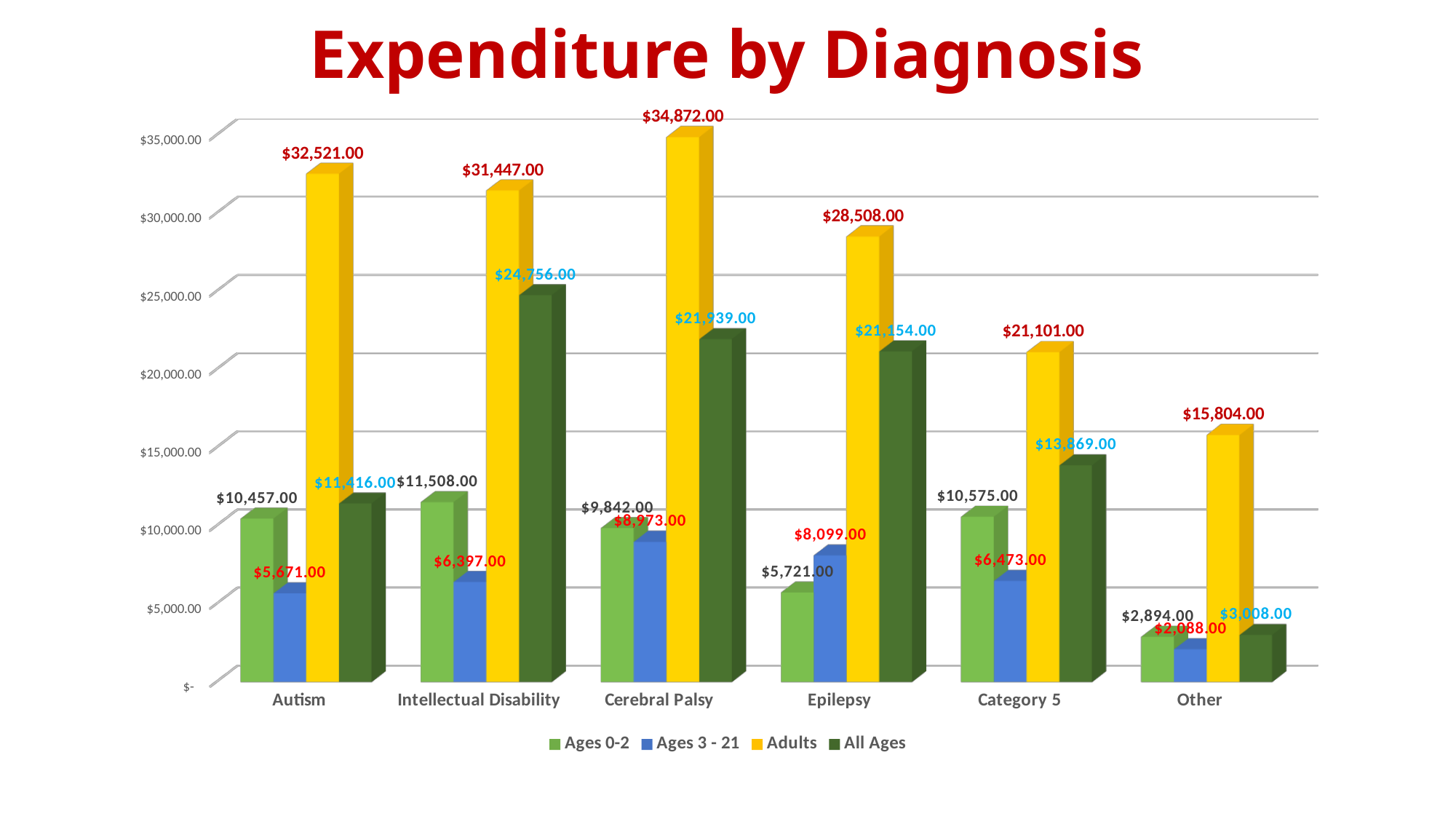
What is the difference between the Adults and Ages 0-2 expenditure for Autism? $22,064.00 Which diagnosis has the highest Adults expenditure? Cerebral Palsy Which is larger, the Ages 0-2 expenditure for Intellectual Disability or for Category 5? Intellectual Disability What is the All Ages expenditure for Intellectual Disability? $24,756.00 Which diagnosis has the lowest All Ages expenditure? Other How many series does the legend list? 4 What is the Adults expenditure for Cerebral Palsy? $34,872.00 What is the Ages 3 - 21 expenditure for Epilepsy? $8,099.00 How many diagnosis categories are shown on the x axis? 6 What is the title of the chart? Expenditure by Diagnosis Which diagnosis has the highest Ages 0-2 expenditure? Intellectual Disability What kind of chart is shown on the slide? Bar chart